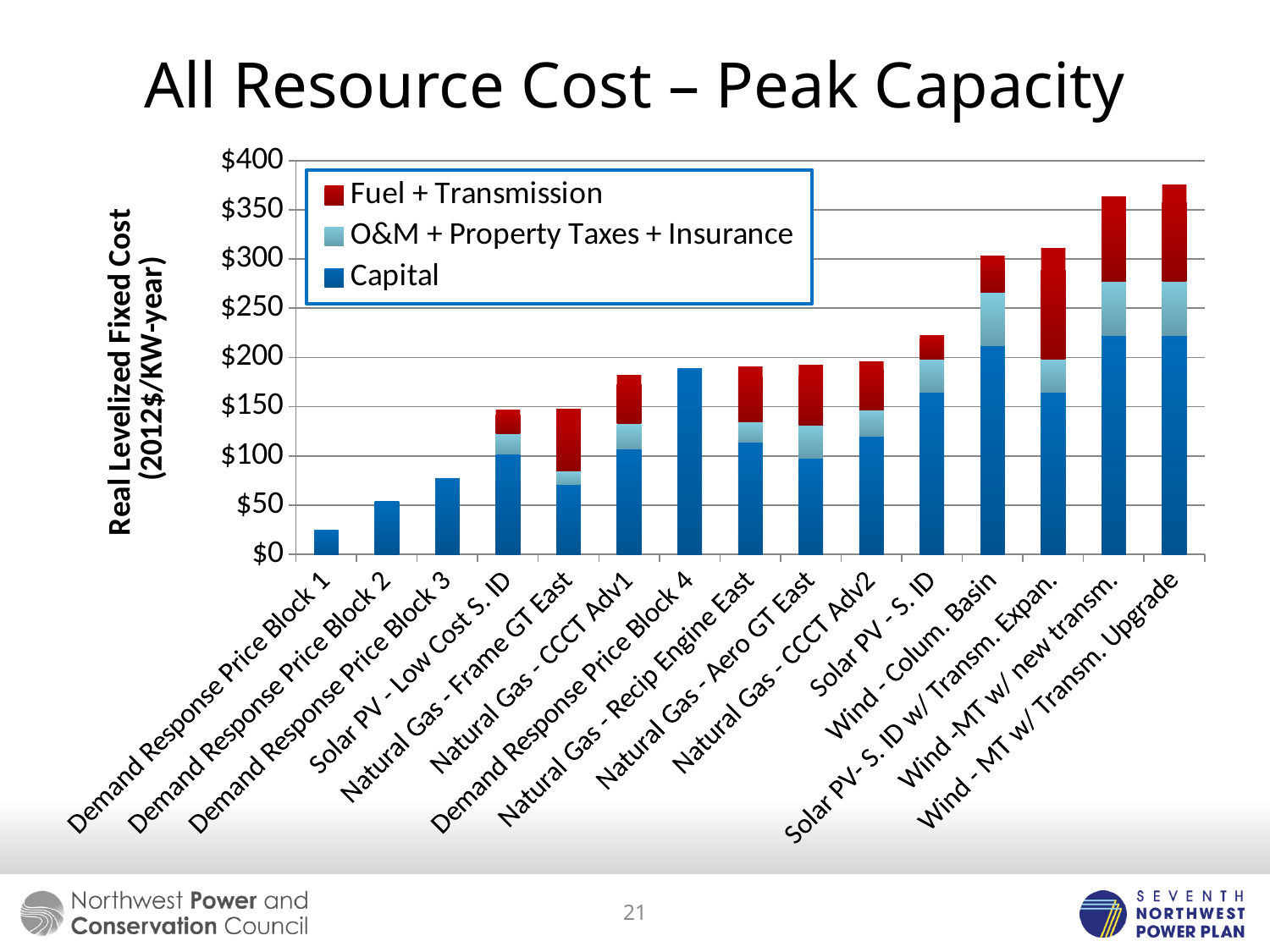
Is the total value for Wind - MT w/ Transm. Upgrade greater or less than $350? greater How many resource categories are plotted along the x axis? 15 How many series does the legend list? 3 Is the total value for Solar PV - S. ID greater or less than $200? greater Is the total value for Demand Response Price Block 1 greater or less than $50? less What kind of chart is shown on the slide? Stacked bar chart Do the total bar heights generally rise or fall moving left to right along the x axis? Rise Which resource has the lowest total real levelized fixed cost? Demand Response Price Block 1 What is the label on the y axis? Real Levelized Fixed Cost (2012$/KW-year) Which has a higher total cost, Wind - Colum. Basin or Solar PV - S. ID? Wind - Colum. Basin